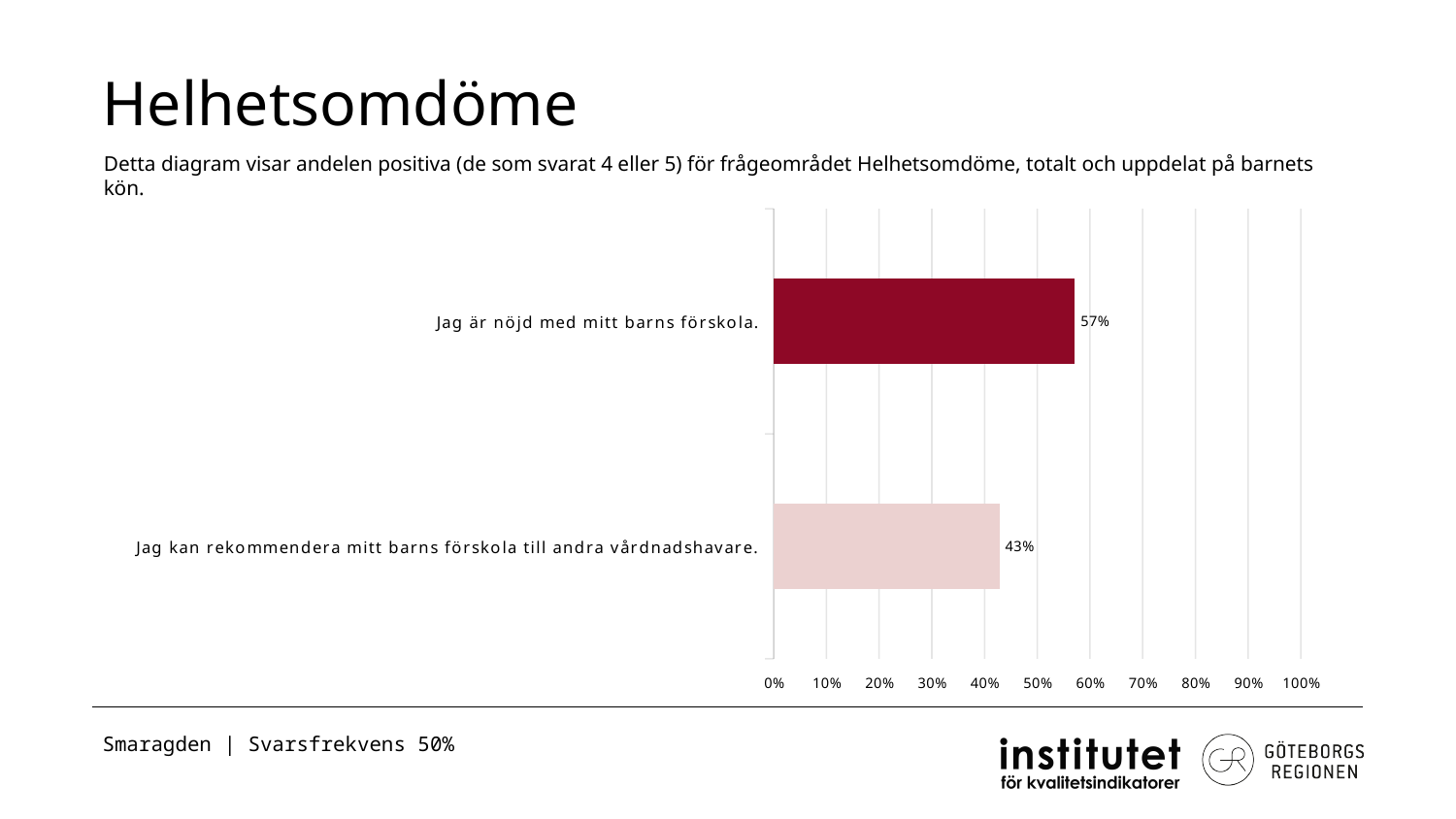
Is the value for "Jag är nöjd med mitt barns förskola." greater or less than 50%? greater What is the difference between the values for "Jag är nöjd med mitt barns förskola." and "Jag kan rekommendera mitt barns förskola till andra vårdnadshavare."? 14% Which category has the highest value? Jag är nöjd med mitt barns förskola. Which is larger: the value for "Jag är nöjd med mitt barns förskola." or for "Jag kan rekommendera mitt barns förskola till andra vårdnadshavare."? Jag är nöjd med mitt barns förskola. What is the value for "Jag är nöjd med mitt barns förskola."? 57% Which category has the lowest value? Jag kan rekommendera mitt barns förskola till andra vårdnadshavare. What is the value for "Jag kan rekommendera mitt barns förskola till andra vårdnadshavare."? 43% What is the title of the slide containing the chart? Helhetsomdöme How many categories are shown in the chart? 2 Is the value for "Jag kan rekommendera mitt barns förskola till andra vårdnadshavare." greater or less than 50%? less What kind of chart is shown on the slide? bar chart What is the maximum value shown on the x axis? 100%